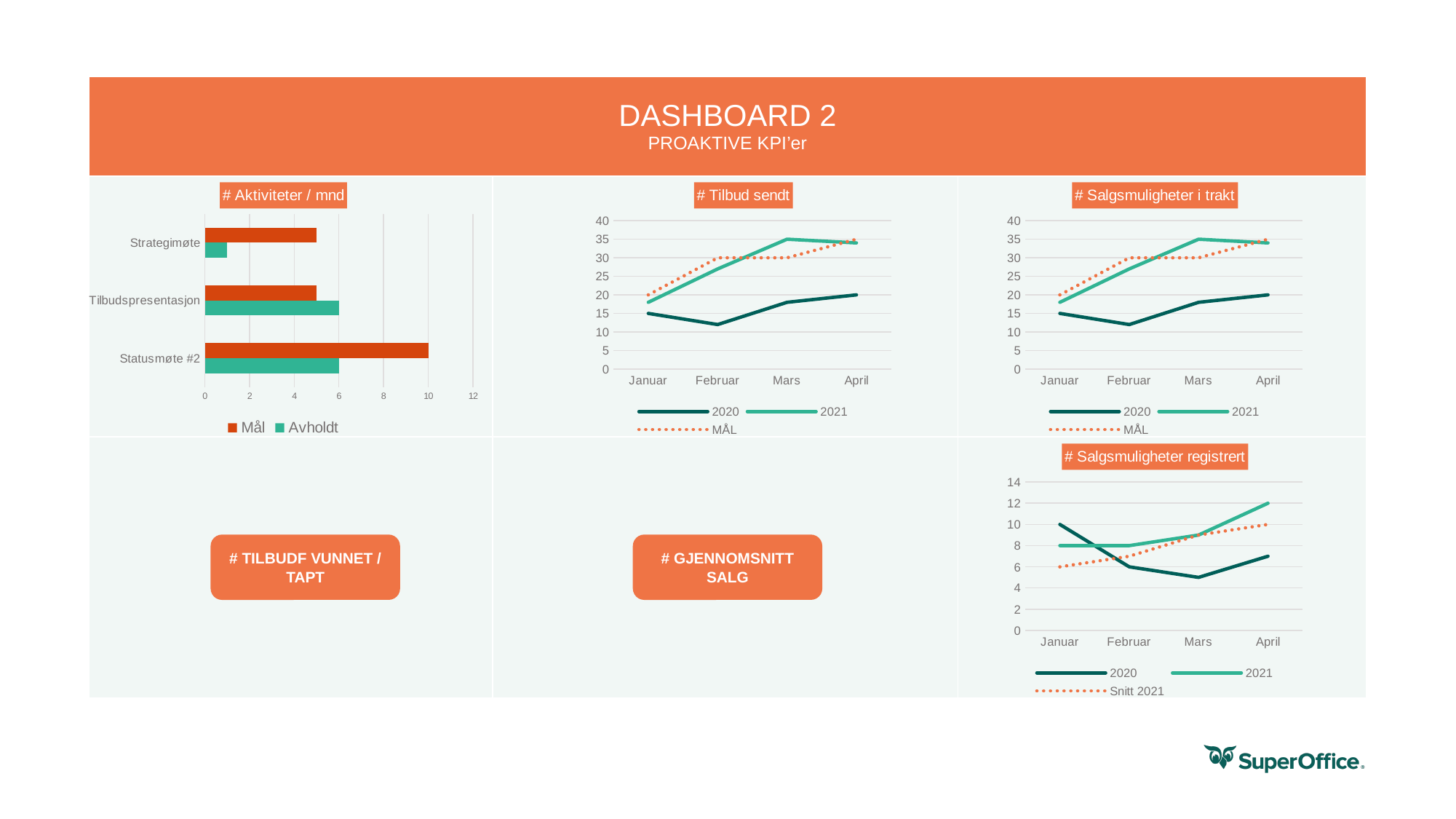
What kind of chart is '# Aktiviteter / mnd'? bar chart In the '# Salgsmuligheter registrert' chart, which is larger in Januar, the 2020 value or the 2021 value? 2020 In the '# Aktiviteter / mnd' chart, is the Avholdt value for Strategimøte greater or less than 2? less In the '# Tilbud sendt' chart, is the 2021 value for Februar greater or less than 25? greater How many series does the legend of the '# Aktiviteter / mnd' chart list? 2 In the '# Tilbud sendt' chart, which month has the lowest 2020 value? Februar How many series does the legend of the '# Salgsmuligheter i trakt' chart list? 3 In the '# Aktiviteter / mnd' chart, what is the Mål value for Statusmøte #2? 10 In the '# Aktiviteter / mnd' chart, what is the Avholdt value for Tilbudspresentasjon? 6 In the '# Aktiviteter / mnd' chart, which category has the highest Mål value? Statusmøte #2 In the '# Salgsmuligheter registrert' chart, what is the 2021 value for April? 12 In the '# Tilbud sendt' chart, what is the 2020 value for Januar? 15